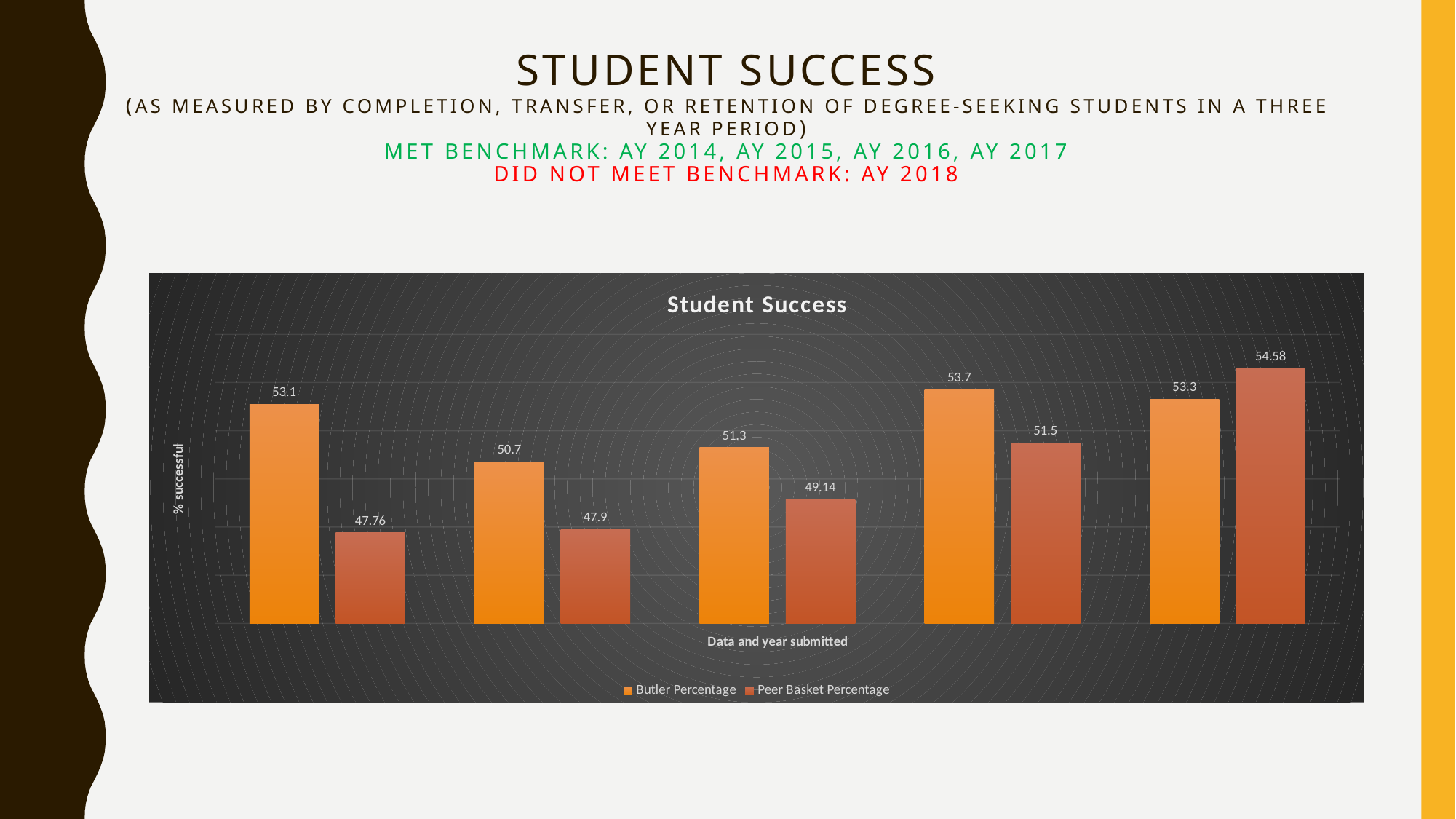
In the leftmost group of bars, how much higher is the Butler Percentage than the Peer Basket Percentage? 5.34 What is the Peer Basket Percentage value for the rightmost group of bars? 54.58 What is the highest Butler Percentage value shown in the chart? 53.7 In the rightmost group of bars, which series has the larger value, Butler Percentage or Peer Basket Percentage? Peer Basket Percentage What is the Butler Percentage value for the leftmost group of bars? 53.1 What is the highest Peer Basket Percentage value shown in the chart? 54.58 What is the label on the vertical axis of the chart? % successful What type of chart is shown on the slide? bar chart How many series does the legend of the Student Success chart list? 2 What is the lowest Peer Basket Percentage value shown in the chart? 47.76 What is the lowest Butler Percentage value shown in the chart? 50.7 How many groups of bars are plotted in the Student Success chart? 5